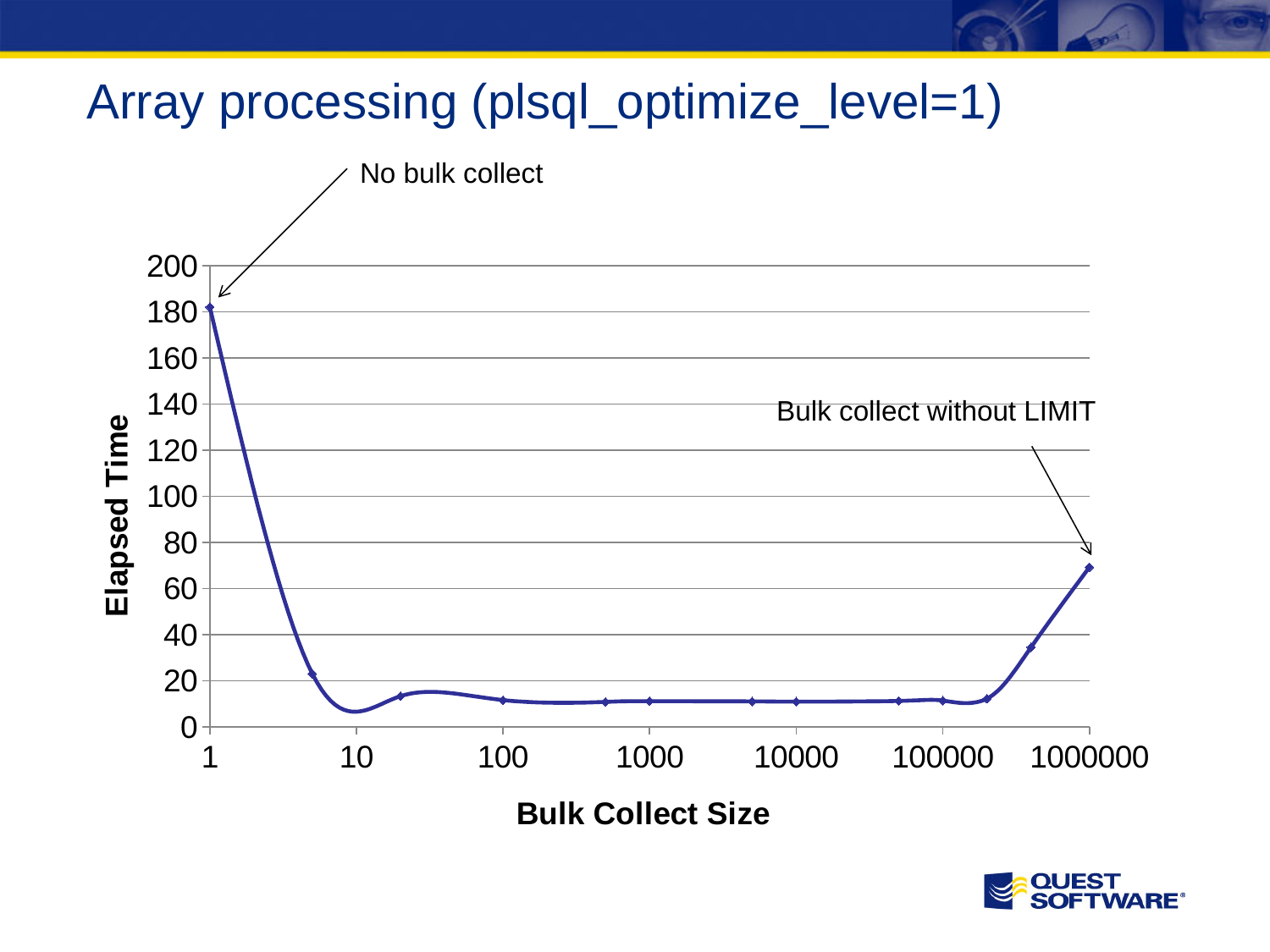
What is the title of the chart? Array processing (plsql_optimize_level=1) Does the elapsed time rise or fall as the bulk collect size increases from 1 to 100? fall Is the elapsed time at bulk collect size 1000000 greater or less than 80? less What is the label of the x axis? Bulk Collect Size Is the elapsed time at bulk collect size 1000 greater or less than 20? less Which has the larger elapsed time: bulk collect size 1 or bulk collect size 1000000? bulk collect size 1 At which bulk collect size is the elapsed time highest? 1 What kind of chart is shown on the slide? line chart Is the elapsed time at bulk collect size 1 greater or less than 160? greater Does the elapsed time rise or fall as the bulk collect size increases from 100000 to 1000000? rise Which has the larger elapsed time: bulk collect size 1000000 or bulk collect size 10000? bulk collect size 1000000